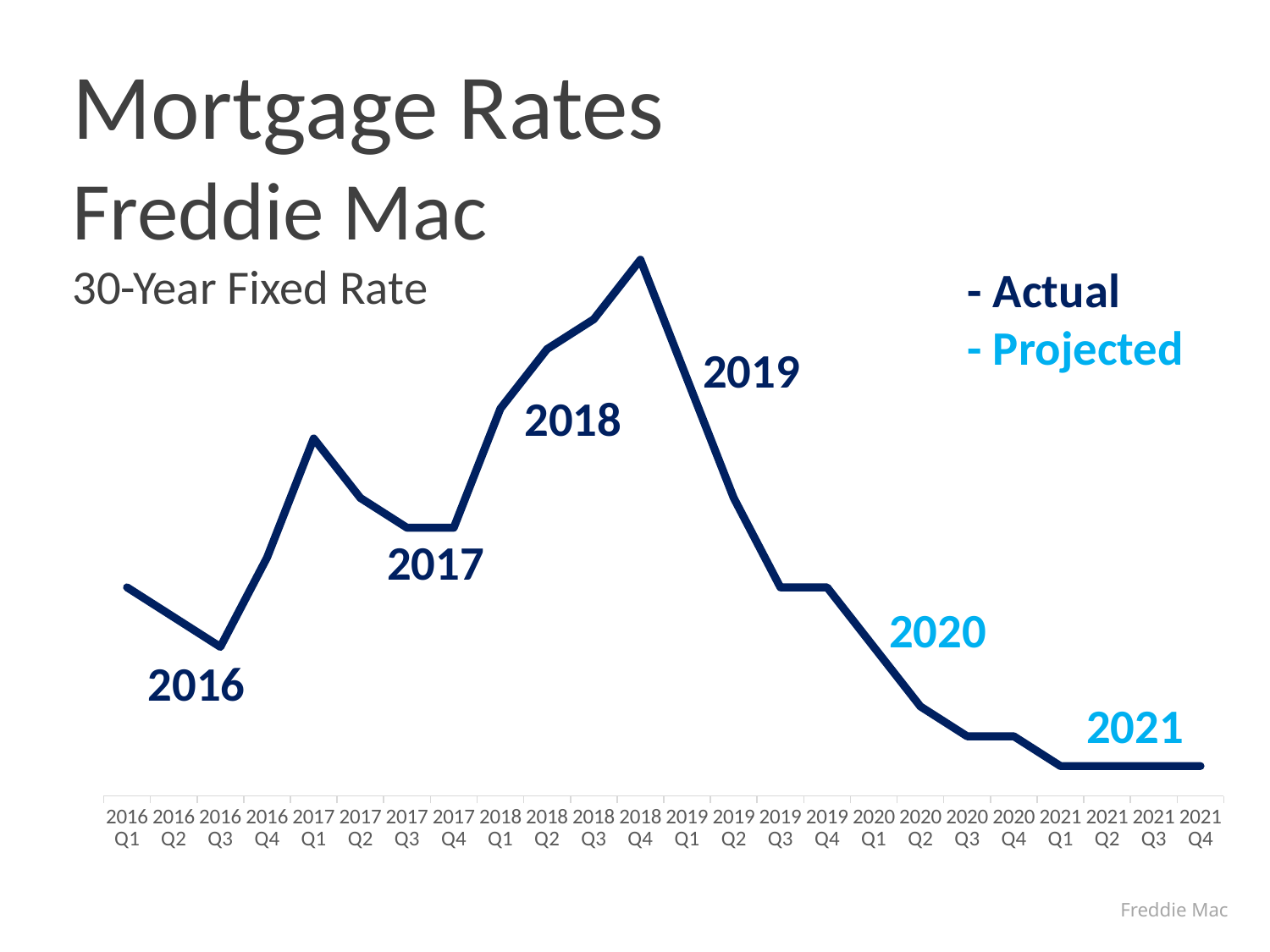
Does the line rise or fall from 2016 Q1 to 2016 Q3? Fall In which year does the line reach its lowest level? 2021 What rate type does the subtitle say the chart shows? 30-Year Fixed Rate Which is higher, the rate at 2018 Q4 or the rate at 2016 Q3? 2018 Q4 What kind of chart is shown on the slide? Line chart Which is higher, the rate at 2017 Q1 or the rate at 2020 Q3? 2017 Q1 How many years are covered on the x axis of the chart? 6 Does the line rise or fall from 2019 Q1 to 2020 Q4? Fall Does the line rise or fall from 2017 Q4 to 2018 Q4? Rise At which quarter does the mortgage rate line reach its highest point? 2018 Q4 How many quarterly points are plotted along the x axis? 24 What two categories does the legend distinguish? Actual and Projected